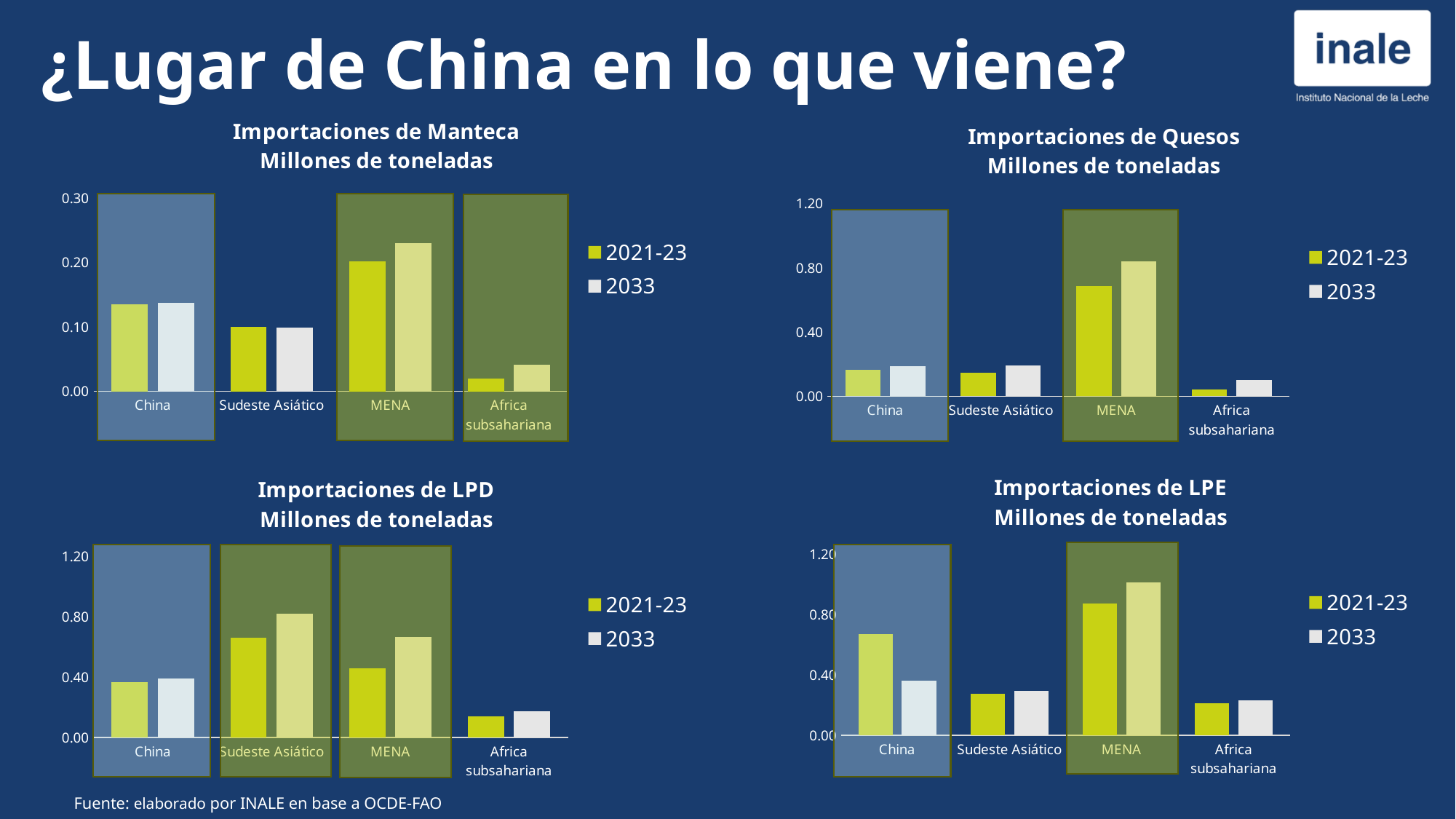
In the 'Importaciones de LPE' chart, which category has the highest value for 2021-23? MENA How many series does the legend of the 'Importaciones de LPD' chart list? 2 In the 'Importaciones de Quesos' chart, is the 2033 value for MENA greater or less than 0.40? greater In the 'Importaciones de Quesos' chart, which category has the lowest value for 2021-23? Africa subsahariana What kind of chart is the 'Importaciones de Manteca' chart? bar chart In the 'Importaciones de LPE' chart, is the 2033 value for MENA greater or less than 0.80? greater In the 'Importaciones de LPD' chart, which category has the highest value for 2033? Sudeste Asiático How many categories are shown on the x axis of the 'Importaciones de Quesos' chart? 4 In the 'Importaciones de Manteca' chart, which category has the highest value for 2033? MENA In the 'Importaciones de LPD' chart, is the 2021-23 value for Sudeste Asiático greater or less than 0.40? greater In the 'Importaciones de LPE' chart, which is larger for China: the 2021-23 value or the 2033 value? 2021-23